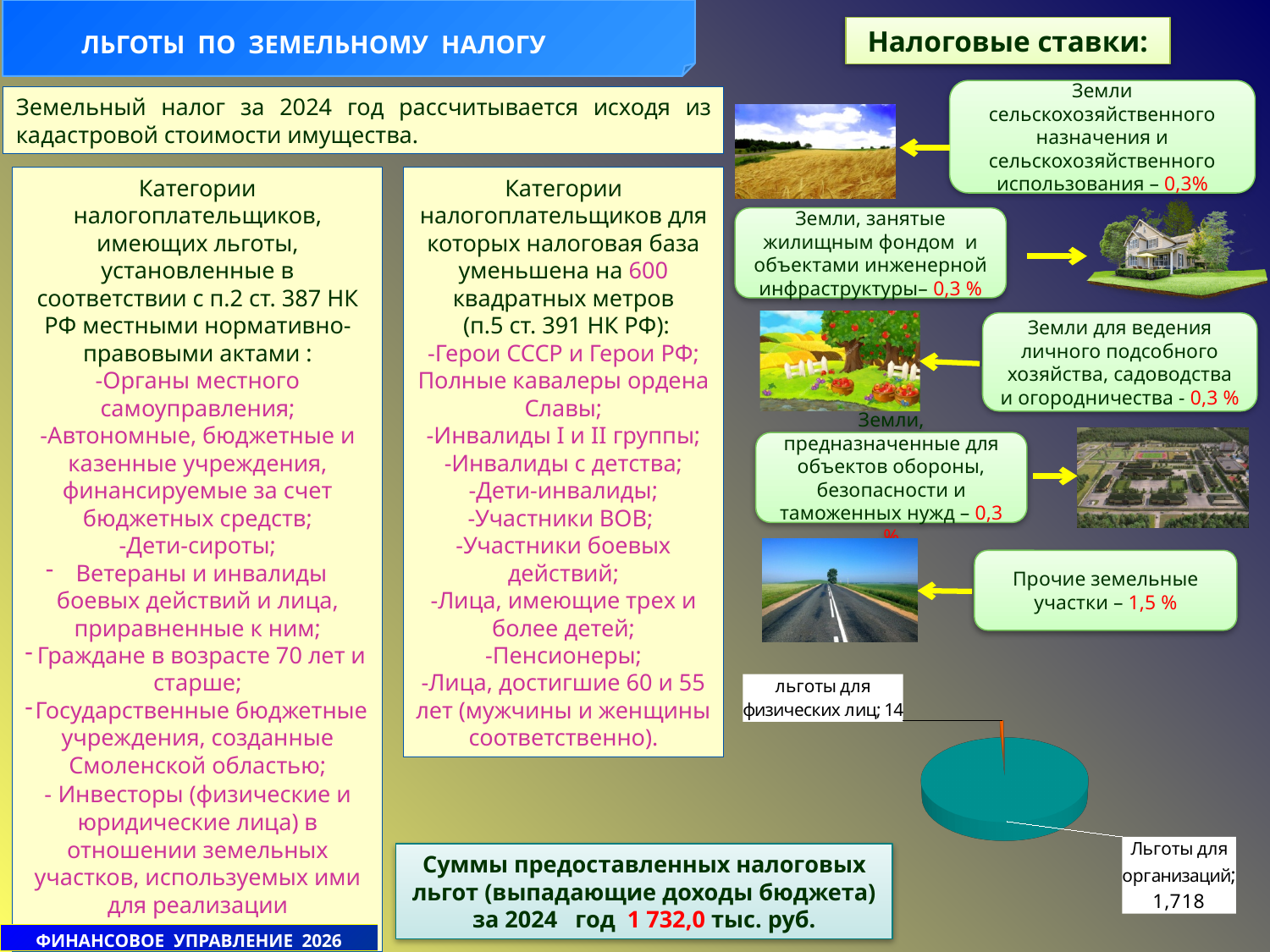
Which category has the smallest slice in the pie chart? льготы для физических лиц What value is shown for the slice 'льготы для физических лиц' in the pie chart? 14 What value is shown for the slice 'Льготы для организаций' in the pie chart? 1,718 Which category has the largest slice in the pie chart? Льготы для организаций What is the total of the two values shown in the pie chart? 1,732 What colour is the large slice of the pie chart? Teal What is the difference between the values for 'Льготы для организаций' and 'льготы для физических лиц' in the pie chart? 1,704 What kind of chart is shown at the bottom right of the slide? Pie chart How many categories (slices) does the pie chart show? 2 In the pie chart, which is larger: the value for 'льготы для физических лиц' or for 'Льготы для организаций'? Льготы для организаций